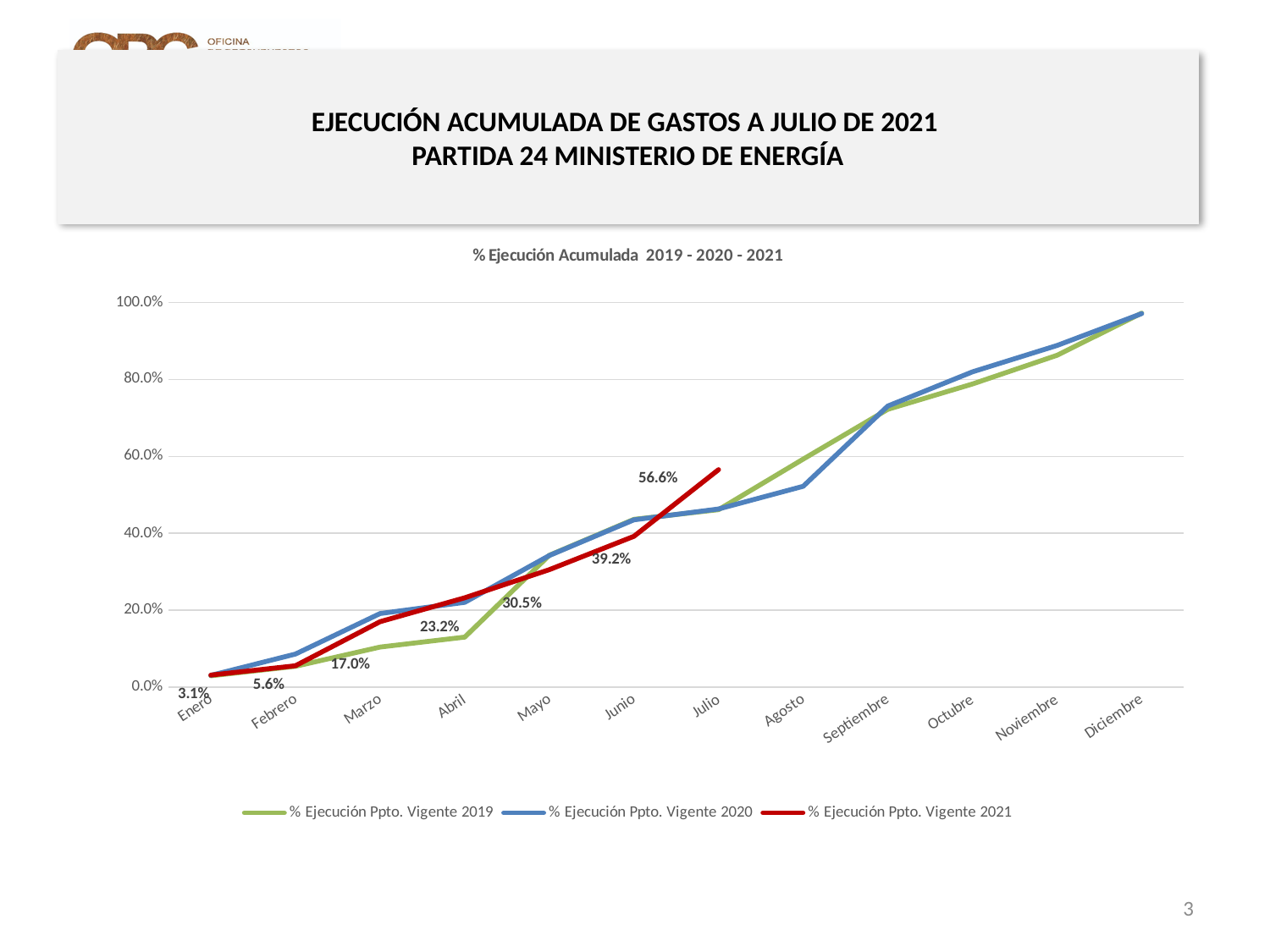
Is the value of % Ejecución Ppto. Vigente 2020 for Diciembre greater or less than 80.0%? greater What is the difference between the 2021 values for Julio and Junio? 17.4% What is the value of % Ejecución Ppto. Vigente 2021 for Enero? 3.1% What is the title of the chart? % Ejecución Acumulada 2019 - 2020 - 2021 What is the value of % Ejecución Ppto. Vigente 2021 for Mayo? 30.5% Does the % Ejecución Ppto. Vigente 2021 series rise or fall from Enero to Julio? rise What is the value of % Ejecución Ppto. Vigente 2021 for Julio? 56.6% What is the difference between the 2021 values for Marzo and Febrero? 11.4% How many series does the legend list? 3 How many months are shown on the x axis? 12 What is the value of % Ejecución Ppto. Vigente 2021 for Abril? 23.2% What kind of chart is shown on the slide? line chart